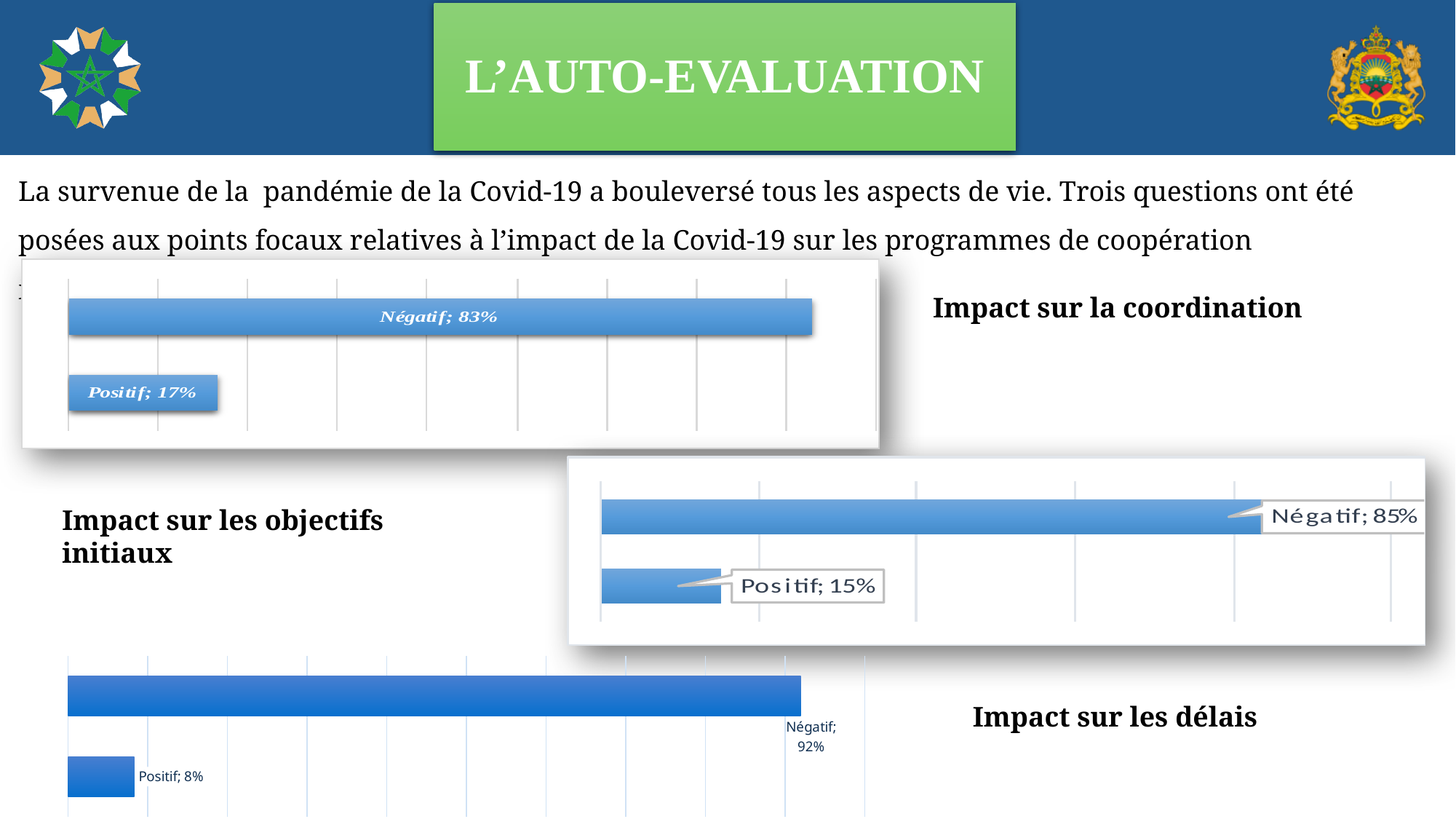
In the 'Impact sur la coordination' chart (top), which category has the lowest value? Positif In the 'Impact sur les délais' chart (bottom), what is the value for Positif? 8% In the 'Impact sur la coordination' chart (top), what is the value for Positif? 17% In the 'Impact sur la coordination' chart (top), what is the value for Négatif? 83% How many categories are shown in the 'Impact sur la coordination' chart (top)? 2 In the 'Impact sur les délais' chart (bottom), which is larger, Négatif or Positif? Négatif In the 'Impact sur les objectifs initiaux' chart (middle), what is the value for Positif? 15% In the 'Impact sur les délais' chart (bottom), what is the value for Négatif? 92% In the 'Impact sur les objectifs initiaux' chart (middle), what is the difference between the Négatif and Positif values? 70% In the 'Impact sur les délais' chart (bottom), which category has the highest value? Négatif What type of chart is the 'Impact sur les délais' chart (bottom)? Bar chart In the 'Impact sur les objectifs initiaux' chart (middle), what is the value for Négatif? 85%